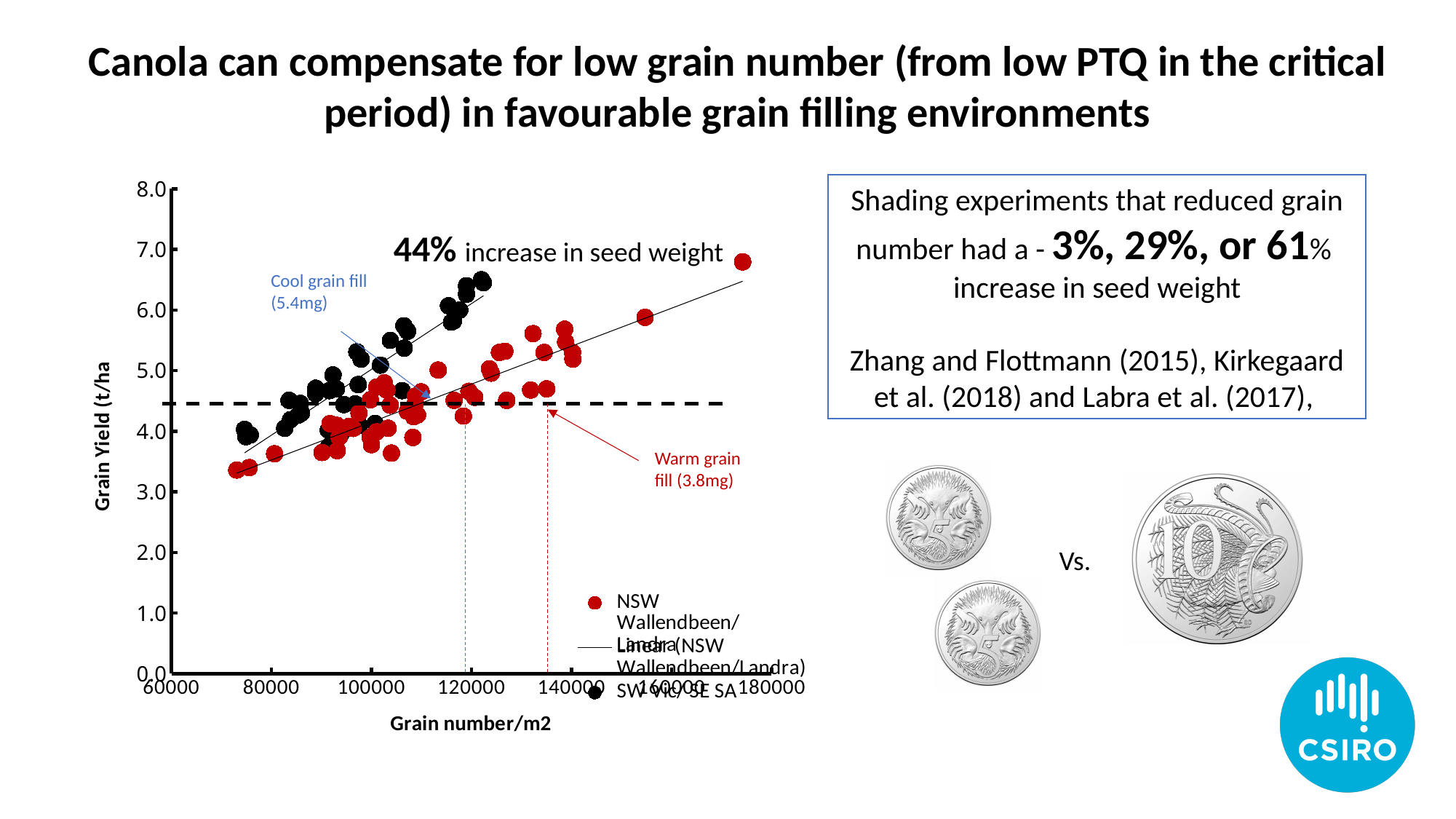
What seed weight is given for cool grain fill in the chart annotation? 5.4mg What percentage increase in seed weight is annotated on the chart? 44% How many entries does the chart legend list? 3 Is the grain yield of the highest NSW Wallendbeen/Landra point greater or less than 6.0 t/ha? greater What is the title of the x axis of the chart? Grain number/m2 What kind of chart is shown on the slide? scatter chart Is the grain yield of the lowest NSW Wallendbeen/Landra point greater or less than 4.0 t/ha? less What is the highest value shown on the y axis of the chart? 8.0 At a grain number of about 100000 per m2, which series shows higher grain yields, NSW Wallendbeen/Landra or SW Vic/ SE SA? SW Vic/ SE SA What colour are the NSW Wallendbeen/Landra points in the chart? red Does grain yield rise or fall as grain number per m2 increases in the chart? rise What seed weight is given for warm grain fill in the chart annotation? 3.8mg